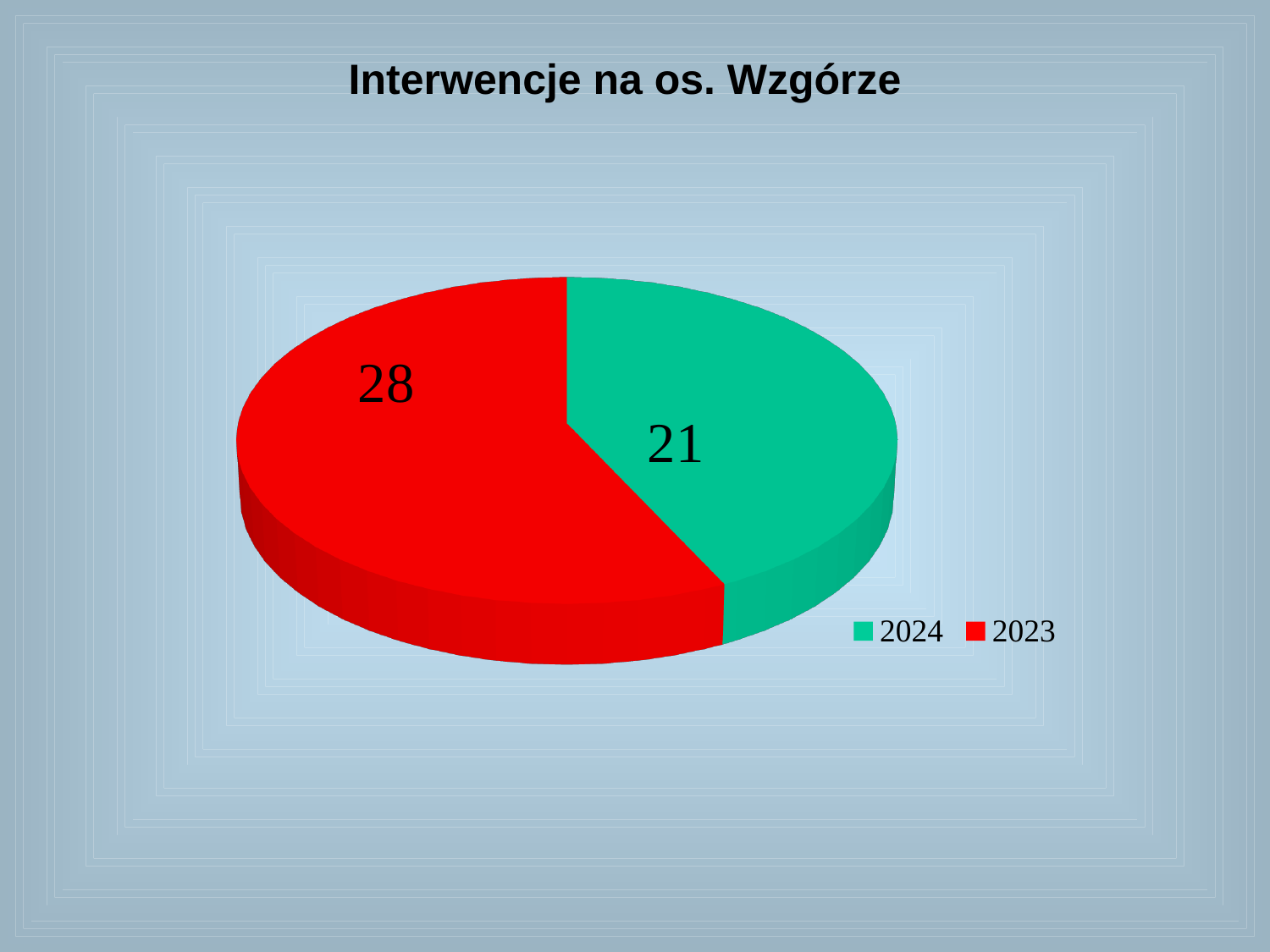
What is the title of the chart? Interwencje na os. Wzgórze What is the total of the two slices in the pie chart? 49 What kind of chart is shown on the slide? pie chart What is the difference between the values for 2023 and 2024? 7 What is the value for 2023 in the pie chart? 28 How many slices does the pie chart have? 2 How many entries does the legend list? 2 Which year has the larger slice in the pie chart? 2023 Is the value for 2024 larger or smaller than the value for 2023? smaller What is the value for 2024 in the pie chart? 21 Which year has the smaller slice in the pie chart? 2024 Which colour represents 2023 in the pie chart? red